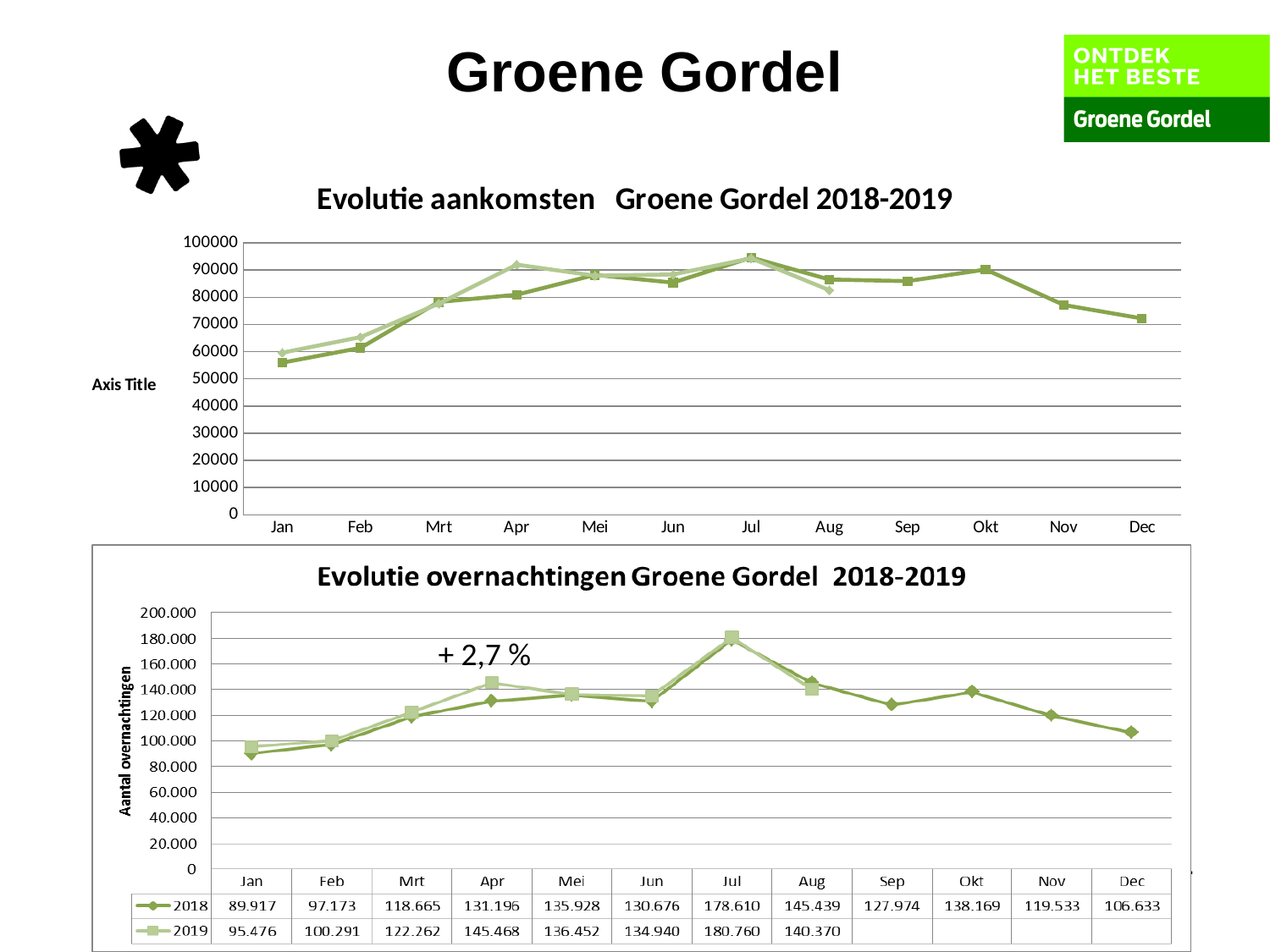
How many series does the legend of the chart 'Evolutie overnachtingen Groene Gordel 2018-2019' list? 2 What kind of chart is 'Evolutie aankomsten Groene Gordel 2018-2019'? line chart In the chart 'Evolutie overnachtingen Groene Gordel 2018-2019', which series has the larger value in Aug, 2018 or 2019? 2018 In the chart 'Evolutie overnachtingen Groene Gordel 2018-2019', which month has the highest value for 2018? Jul In the chart 'Evolutie overnachtingen Groene Gordel 2018-2019', what is the value for 2019 in Apr? 145.468 In the chart 'Evolutie overnachtingen Groene Gordel 2018-2019', which month has the lowest value for 2018? Jan In the chart 'Evolutie overnachtingen Groene Gordel 2018-2019', what is the value for 2018 in Jul? 178.610 In the chart 'Evolutie overnachtingen Groene Gordel 2018-2019', for how many months does the 2019 series have a value? 8 What percentage annotation is printed on the chart 'Evolutie overnachtingen Groene Gordel 2018-2019'? + 2,7 % In the chart 'Evolutie aankomsten Groene Gordel 2018-2019', do the values rise or fall from Okt to Dec? fall In the chart 'Evolutie overnachtingen Groene Gordel 2018-2019', what is the difference between the 2019 and 2018 values in Apr? 14.272 In the chart 'Evolutie aankomsten Groene Gordel 2018-2019', is the value for Dec greater or less than 80000? less